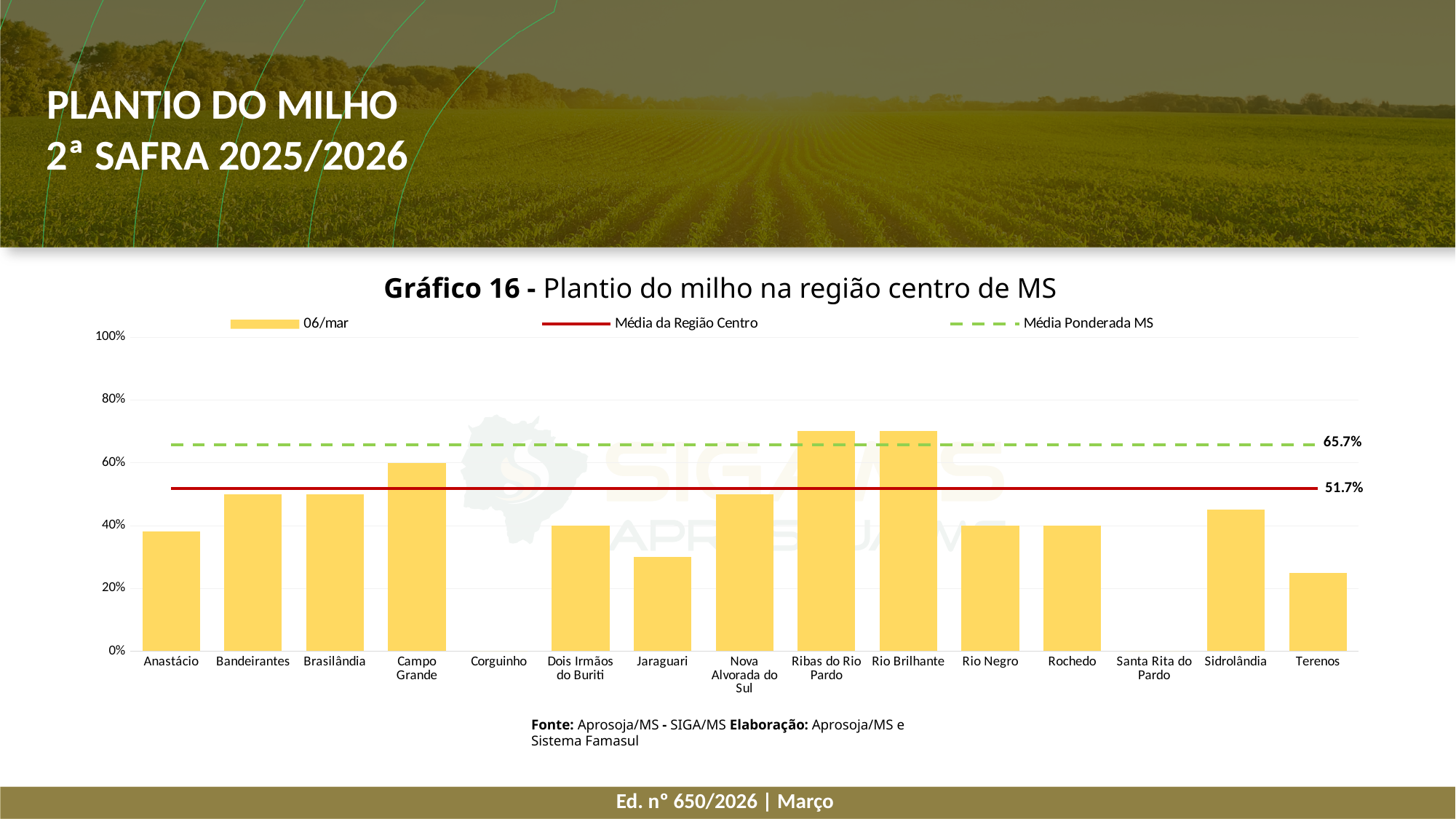
Is the value for Ribas do Rio Pardo greater or less than 60%? greater What value is printed for the Média da Região Centro line? 51.7% Which has the larger value, Jaraguari or Terenos? Jaraguari What date is shown in the legend for the bar series? 06/mar Is the value for Anastácio greater or less than 40%? less What value is printed for the Média Ponderada MS line? 65.7% How many entries does the chart legend list? 3 Is the value for Terenos greater or less than 40%? less What kind of chart is Gráfico 16? bar chart How many municipalities are listed on the x axis of the chart? 15 What is the difference between the Média Ponderada MS (65.7%) and the Média da Região Centro (51.7%)? 14.0 percentage points Which has the larger value, Campo Grande or Anastácio? Campo Grande